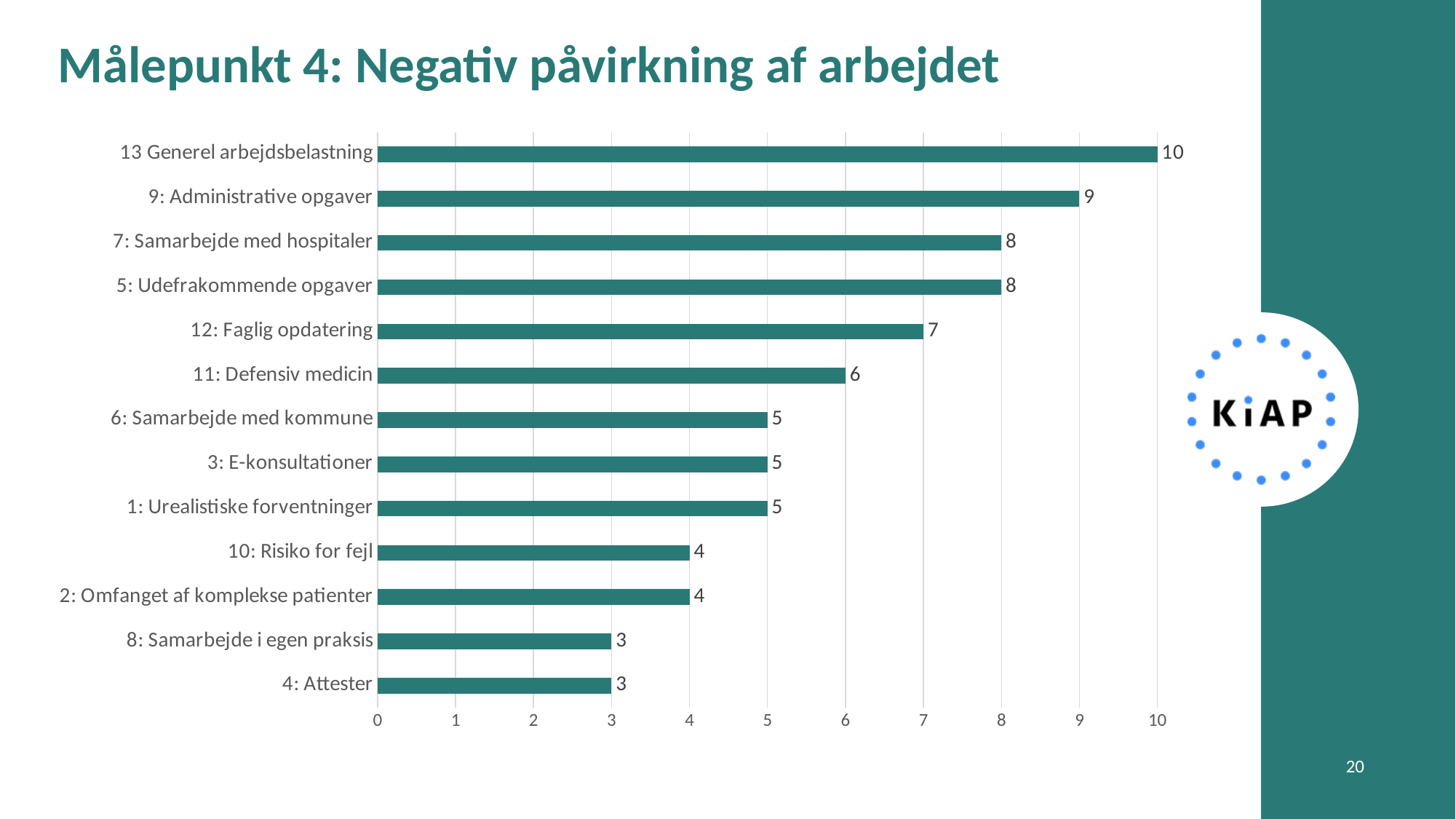
What kind of chart is shown on the slide? bar chart What is the value for "12: Faglig opdatering"? 7 What is the difference between the values for "9: Administrative opgaver" and "10: Risiko for fejl"? 5 Which category has the highest value? 13 Generel arbejdsbelastning How many categories are shown in the chart? 13 Which is larger, the value for "7: Samarbejde med hospitaler" or the value for "6: Samarbejde med kommune"? 7: Samarbejde med hospitaler What is the value for "9: Administrative opgaver"? 9 What is the value for "13 Generel arbejdsbelastning"? 10 What is the highest value shown on the x axis? 10 What is the title of the slide? Målepunkt 4: Negativ påvirkning af arbejdet Is the value for "12: Faglig opdatering" greater or less than 5? greater What is the value for "11: Defensiv medicin"? 6